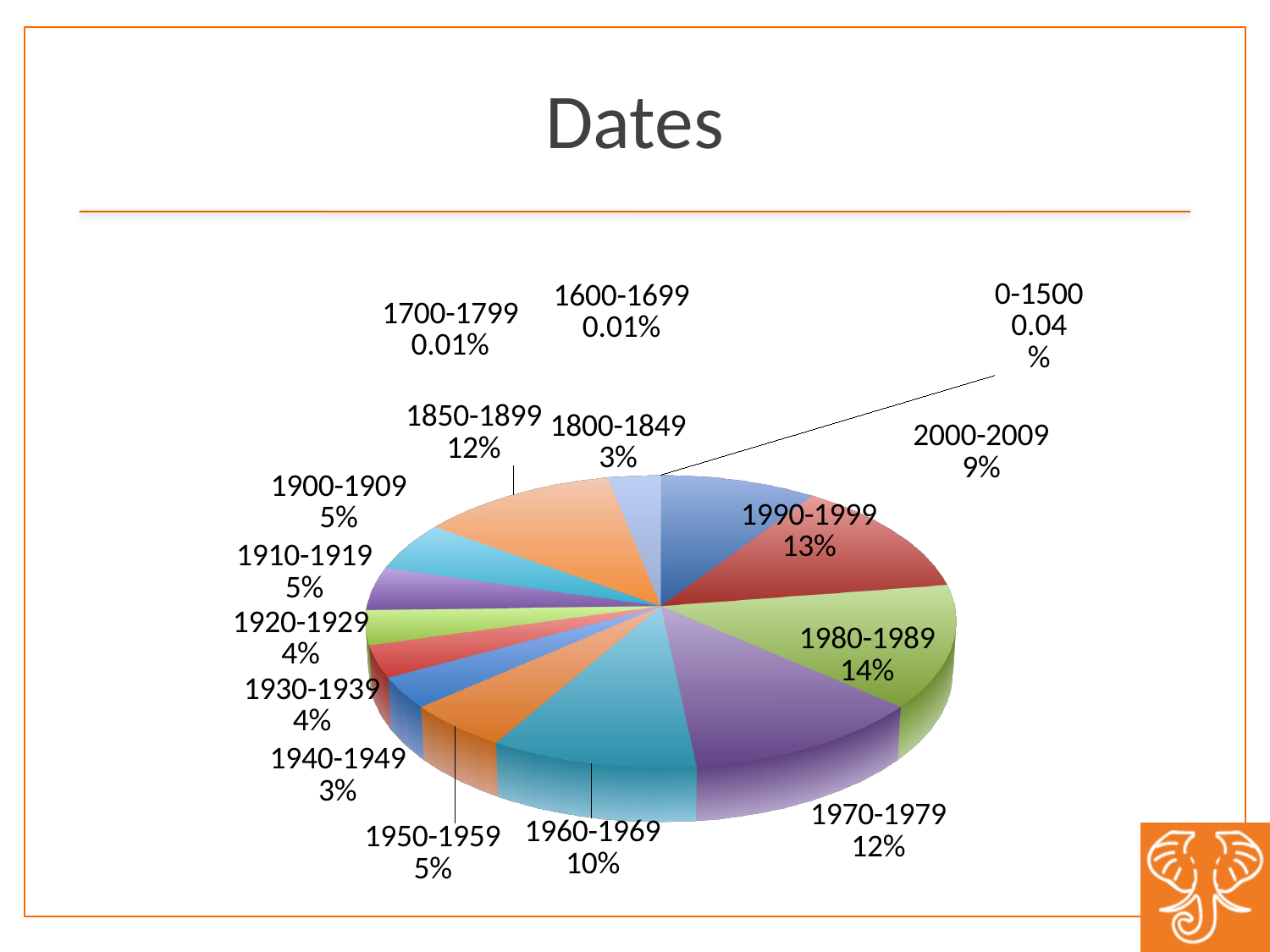
How many date-range categories are labelled on the pie chart? 16 What percentage is shown for the 1960-1969 slice? 10% What percentage is shown for 1850-1899? 12% Which is larger, the slice for 1920-1929 or the slice for 1950-1959? 1950-1959 What is the difference in percentage points between the 1980-1989 slice and the 1990-1999 slice? 1 What is the difference in percentage points between the 1960-1969 slice and the 1940-1949 slice? 7 What value is labelled for the 0-1500 slice? 0.04% Which is larger, the slice for 1990-1999 or the slice for 2000-2009? 1990-1999 What share of the pie does the 1980-1989 slice represent? 14% Which date range has the largest slice of the pie? 1980-1989 What kind of chart is shown on the slide? Pie chart What is the title of the chart on the slide? Dates